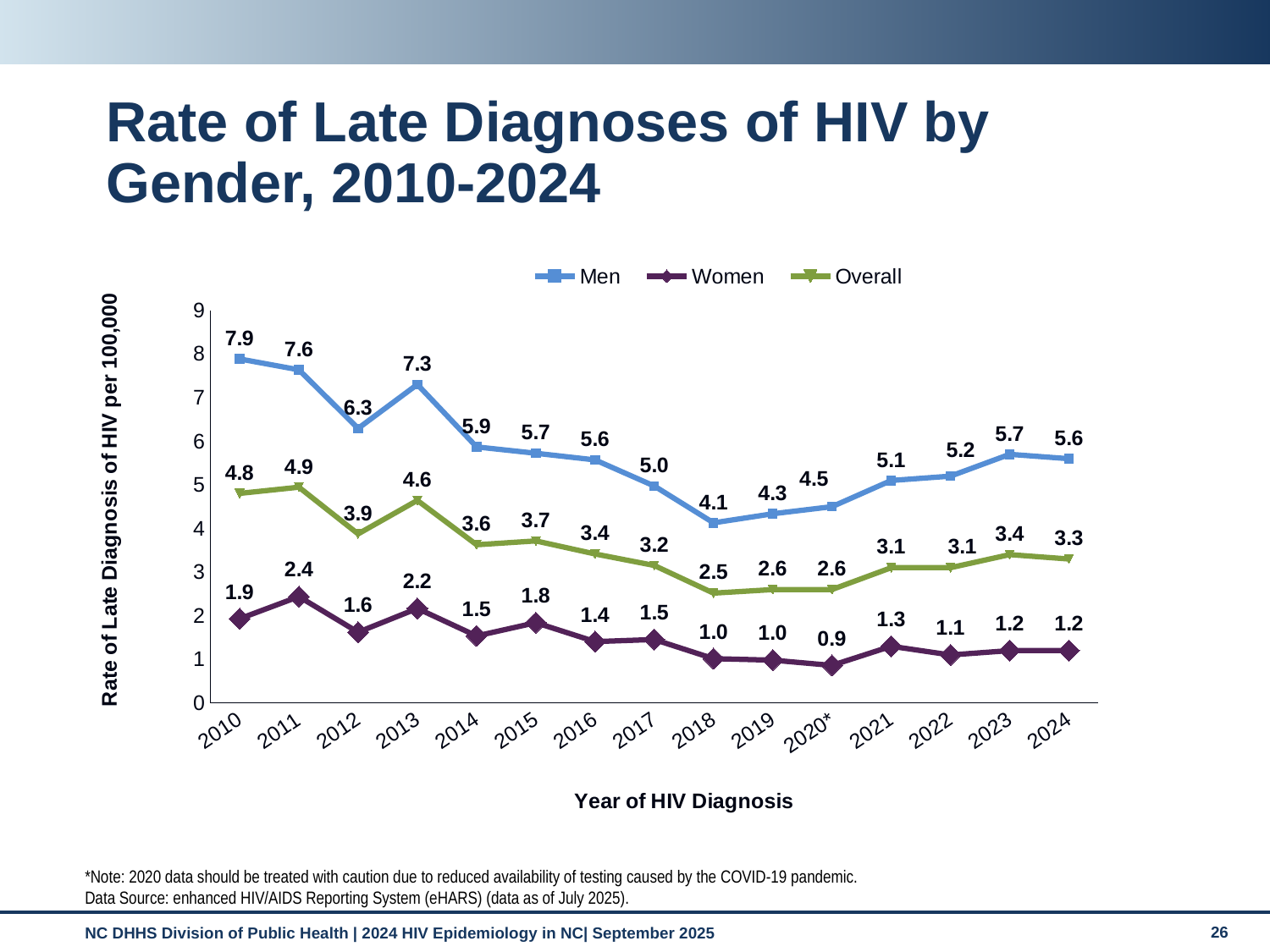
What kind of chart is shown on the slide? Line chart What is the Overall rate of late diagnosis of HIV in 2024? 3.3 In which year is the Overall rate the highest? 2011 How many series does the legend list? 3 What is the difference between the Men and Women rates in 2024? 4.4 Does the rate for Men generally rise or fall from 2010 to 2018? Fall What is the rate of late diagnosis of HIV for Women in 2020*? 0.9 What is the label of the y axis? Rate of Late Diagnosis of HIV per 100,000 Which is larger, the Men rate in 2013 or the Men rate in 2023? 2013 In which year is the rate for Men the lowest? 2018 How many years are shown on the x axis? 15 What is the rate of late diagnosis of HIV for Men in 2010? 7.9